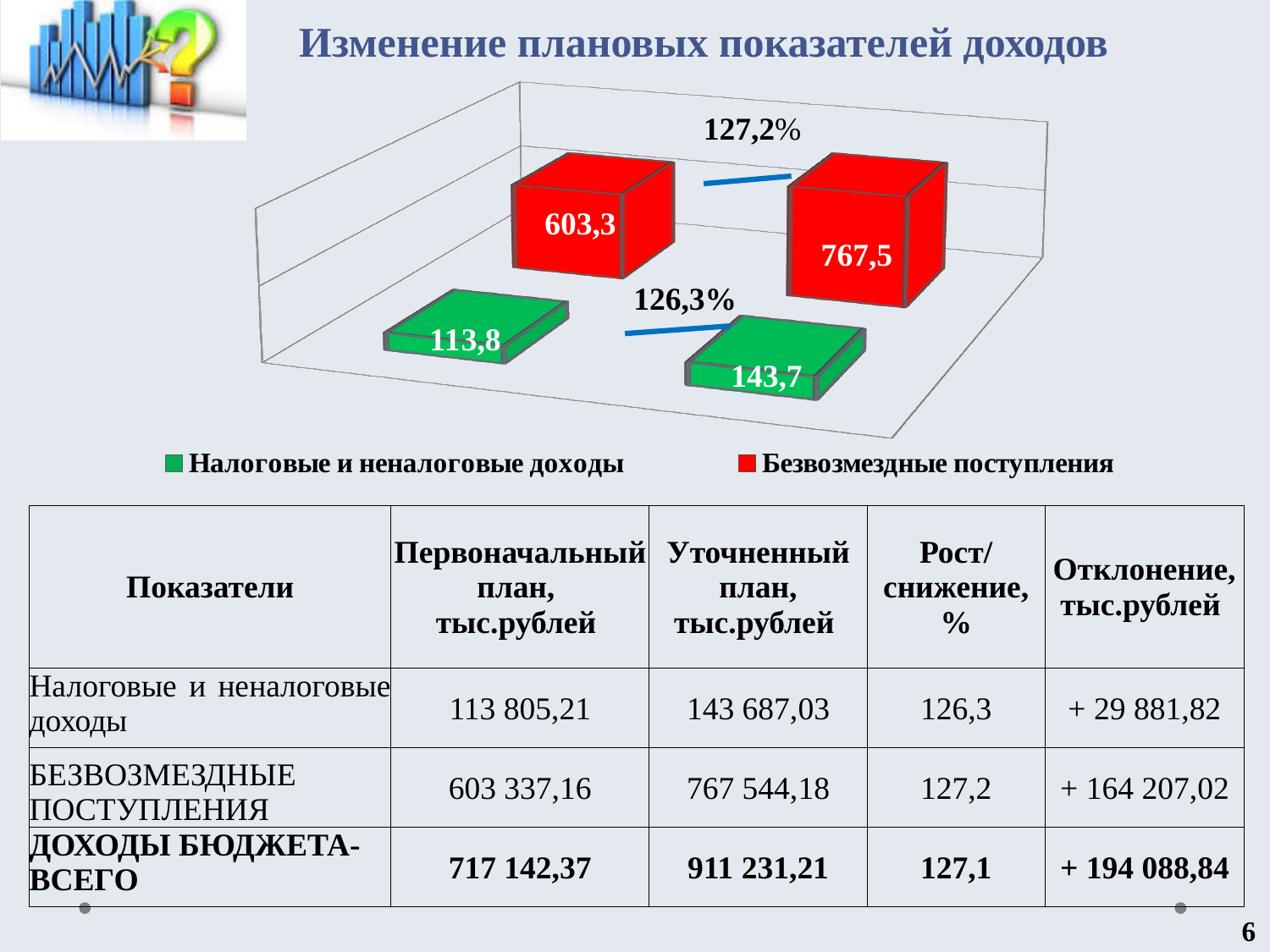
What is the value of the left (first) green bar for Налоговые и неналоговые доходы? 113,8 What percentage label is shown above the red bars for Безвозмездные поступления? 127,2% What is the difference between the two red bars for Безвозмездные поступления (767,5 and 603,3)? 164,2 How many series does the chart legend list? 2 Which bar has the lowest value on the chart? 113,8 (Налоговые и неналоговые доходы, left bar) What is the value of the right (second) green bar for Налоговые и неналоговые доходы? 143,7 Which is larger: the right green bar (143,7) or the left red bar (603,3)? 603,3 (left red bar) Which bar has the highest value on the chart? 767,5 (Безвозмездные поступления, right bar) What is the value of the left (first) red bar for Безвозмездные поступления? 603,3 What is the value of the right (second) red bar for Безвозмездные поступления? 767,5 Do the values for each series rise or fall from the left bar to the right bar? rise What type of chart is shown on the slide? bar chart